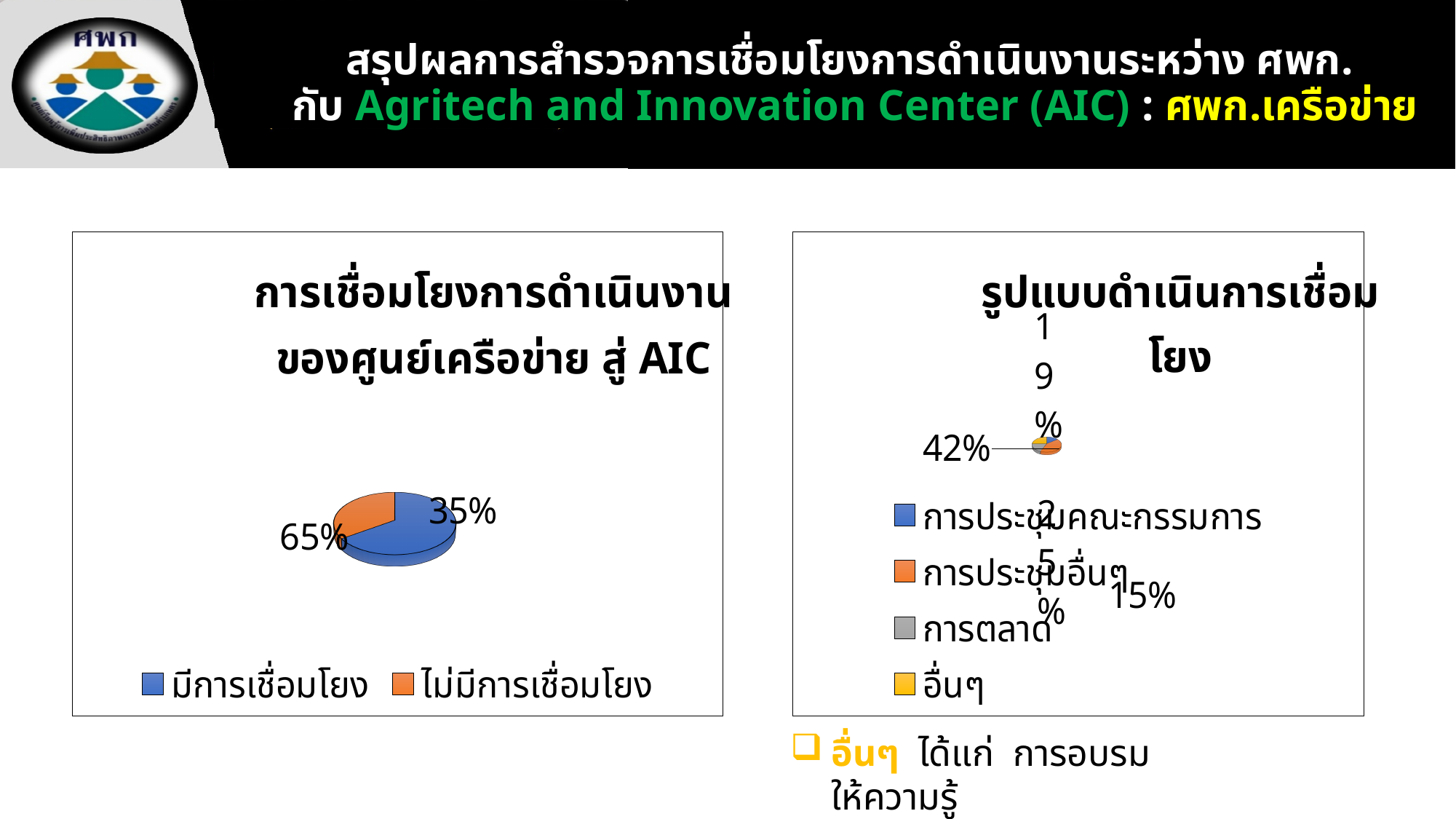
In the left chart (การเชื่อมโยงการดำเนินงานของศูนย์เครือข่าย สู่ AIC), what colour is the slice for ไม่มีการเชื่อมโยง? Orange How many categories does the left chart (การเชื่อมโยงการดำเนินงานของศูนย์เครือข่าย สู่ AIC) show? 2 In the left chart (การเชื่อมโยงการดำเนินงานของศูนย์เครือข่าย สู่ AIC), what percentage is shown for ไม่มีการเชื่อมโยง? 35% In the left chart (การเชื่อมโยงการดำเนินงานของศูนย์เครือข่าย สู่ AIC), which category has the smallest share? ไม่มีการเชื่อมโยง What kind of chart is the left chart (การเชื่อมโยงการดำเนินงานของศูนย์เครือข่าย สู่ AIC)? Pie chart How many categories does the legend of the right chart (รูปแบบดำเนินการเชื่อมโยง) list? 4 In the right chart (รูปแบบดำเนินการเชื่อมโยง), what colour is the legend entry for อื่นๆ? Yellow In the left chart (การเชื่อมโยงการดำเนินงานของศูนย์เครือข่าย สู่ AIC), which category has the largest share? มีการเชื่อมโยง In the left chart (การเชื่อมโยงการดำเนินงานของศูนย์เครือข่าย สู่ AIC), what percentage is shown for มีการเชื่อมโยง? 65% In the left chart (การเชื่อมโยงการดำเนินงานของศูนย์เครือข่าย สู่ AIC), what is the difference in percentage points between มีการเชื่อมโยง and ไม่มีการเชื่อมโยง? 30% In the left chart (การเชื่อมโยงการดำเนินงานของศูนย์เครือข่าย สู่ AIC), which is larger: มีการเชื่อมโยง or ไม่มีการเชื่อมโยง? มีการเชื่อมโยง What kind of chart is the right chart (รูปแบบดำเนินการเชื่อมโยง)? Pie chart